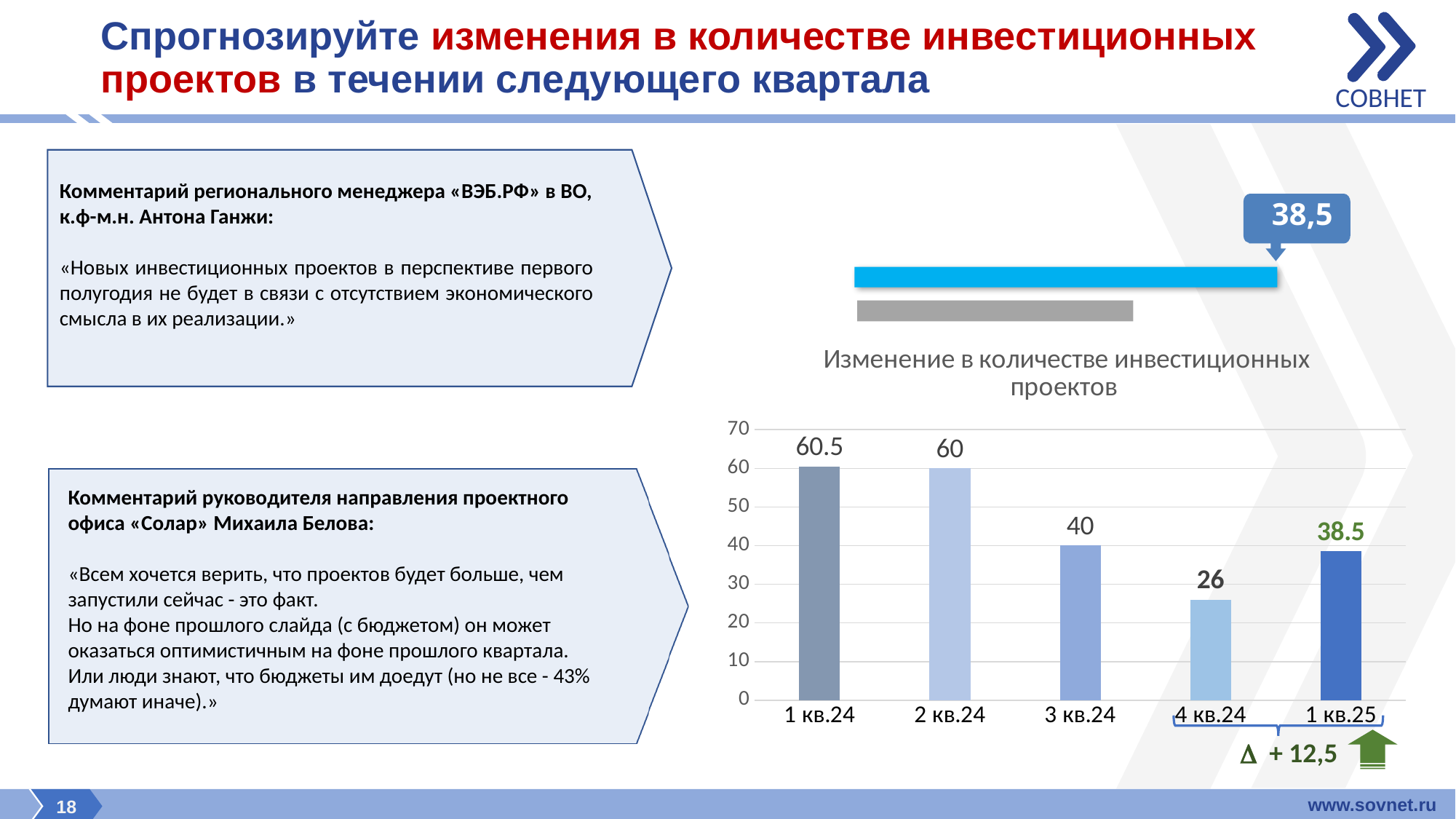
What is the value for 1 кв.24 in the chart "Изменение в количестве инвестиционных проектов"? 60.5 Is the value for 2 кв.24 in the bar chart greater or less than 50? greater Which quarter has the lowest value in the bar chart? 4 кв.24 What is the value for 1 кв.25 in the bar chart? 38.5 Do the values in the bar chart rise or fall from 1 кв.24 to 4 кв.24? fall What is the value for 4 кв.24 in the bar chart? 26 What is the difference between the values for 1 кв.25 and 4 кв.24 in the bar chart? 12.5 Which quarter has the highest value in the bar chart? 1 кв.24 How many quarters are shown on the x axis of the bar chart? 5 What is the value for 3 кв.24 in the bar chart? 40 What kind of chart is "Изменение в количестве инвестиционных проектов"? bar chart Which is larger in the bar chart: the value for 3 кв.24 or the value for 1 кв.25? 3 кв.24